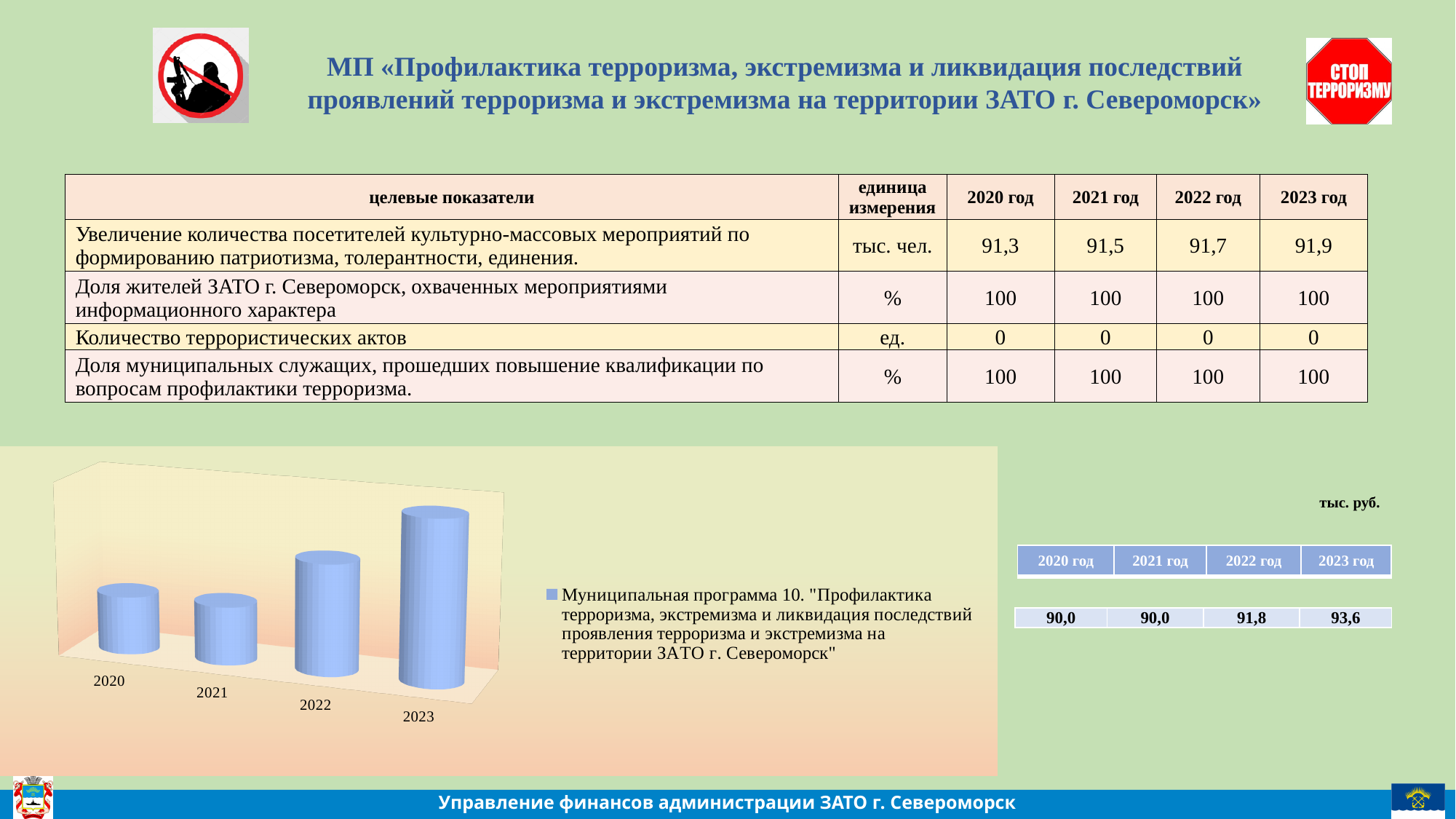
Is the bar for 2023 taller or shorter than the bar for 2022? taller Using the data table next to the bar chart, what is the difference between the 2023 and 2022 values? 1,8 Is the bar for 2022 taller or shorter than the bar for 2020? taller What kind of chart is shown at the bottom left of the slide? bar chart According to the data table next to the bar chart, what is the value for 2022 год? 91,8 How many categories (years) are plotted on the bar chart? 4 According to the data table next to the bar chart, what is the value for 2023 год? 93,6 What unit of measurement is shown above the data table next to the bar chart? тыс. руб. Which year has the tallest bar in the bar chart? 2023 Do the bar heights generally rise or fall from 2020 to 2023? rise How many series does the legend of the bar chart list? 1 According to the data table next to the bar chart, what is the value for 2020 год? 90,0